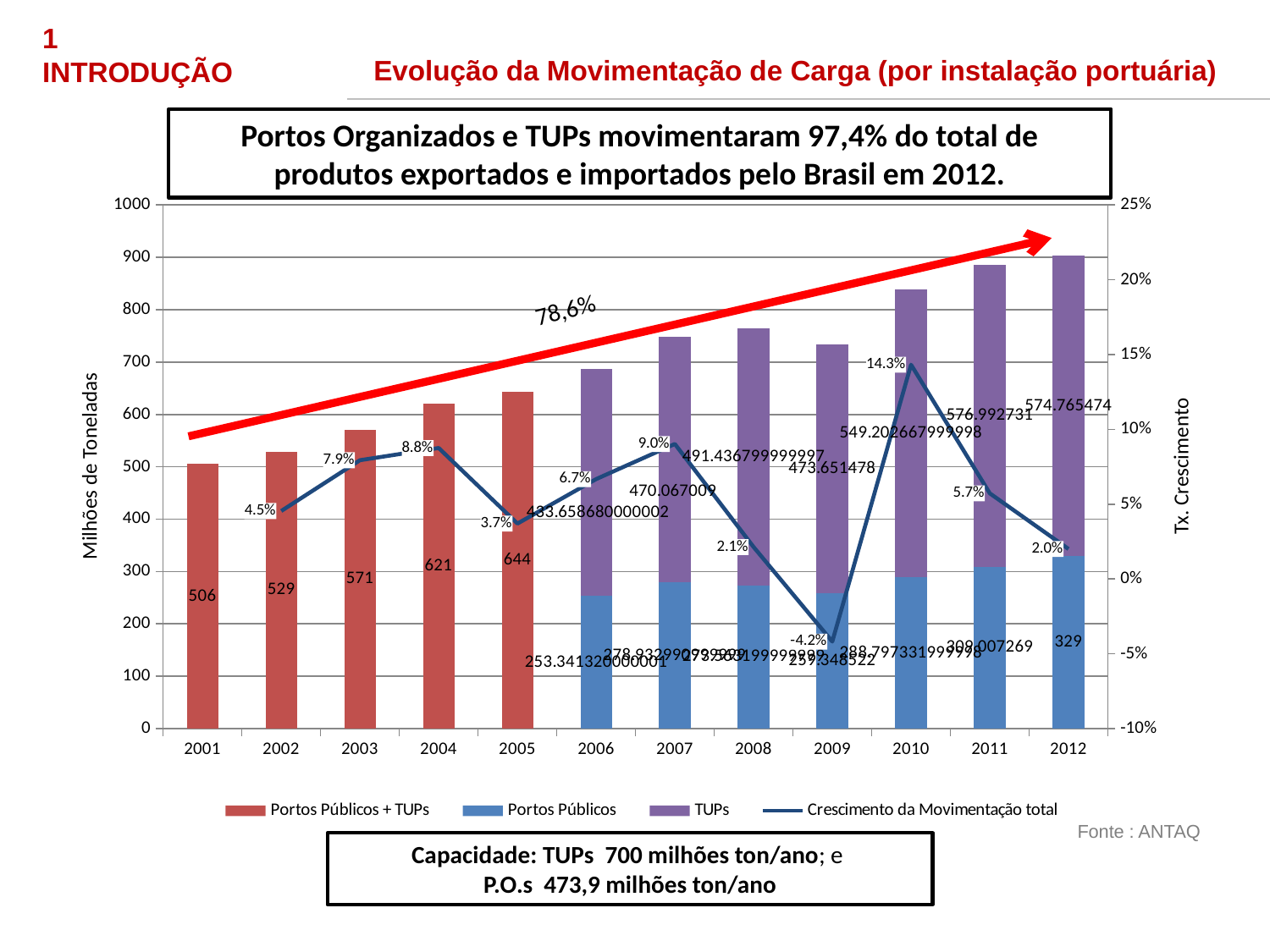
What is the difference between the Portos Públicos + TUPs values for 2005 and 2001? 138 What is the value of the Portos Públicos + TUPs bar for 2005? 644 What is the Crescimento da Movimentação total value for 2009? -4.2% What is the value of the Portos Públicos + TUPs bar for 2001? 506 In which year is the Crescimento da Movimentação total line at its highest? 2010 How many series does the legend list? 4 Do the Portos Públicos + TUPs bars rise or fall from 2001 to 2005? rise In which year is the Crescimento da Movimentação total line at its lowest? 2009 Which is larger, the Portos Públicos + TUPs value for 2004 or for 2002? 2004 How many years are shown on the x axis? 12 What is the Portos Públicos value for 2012? 329 Is the total height of the stacked bar for 2010 greater or less than 800? greater